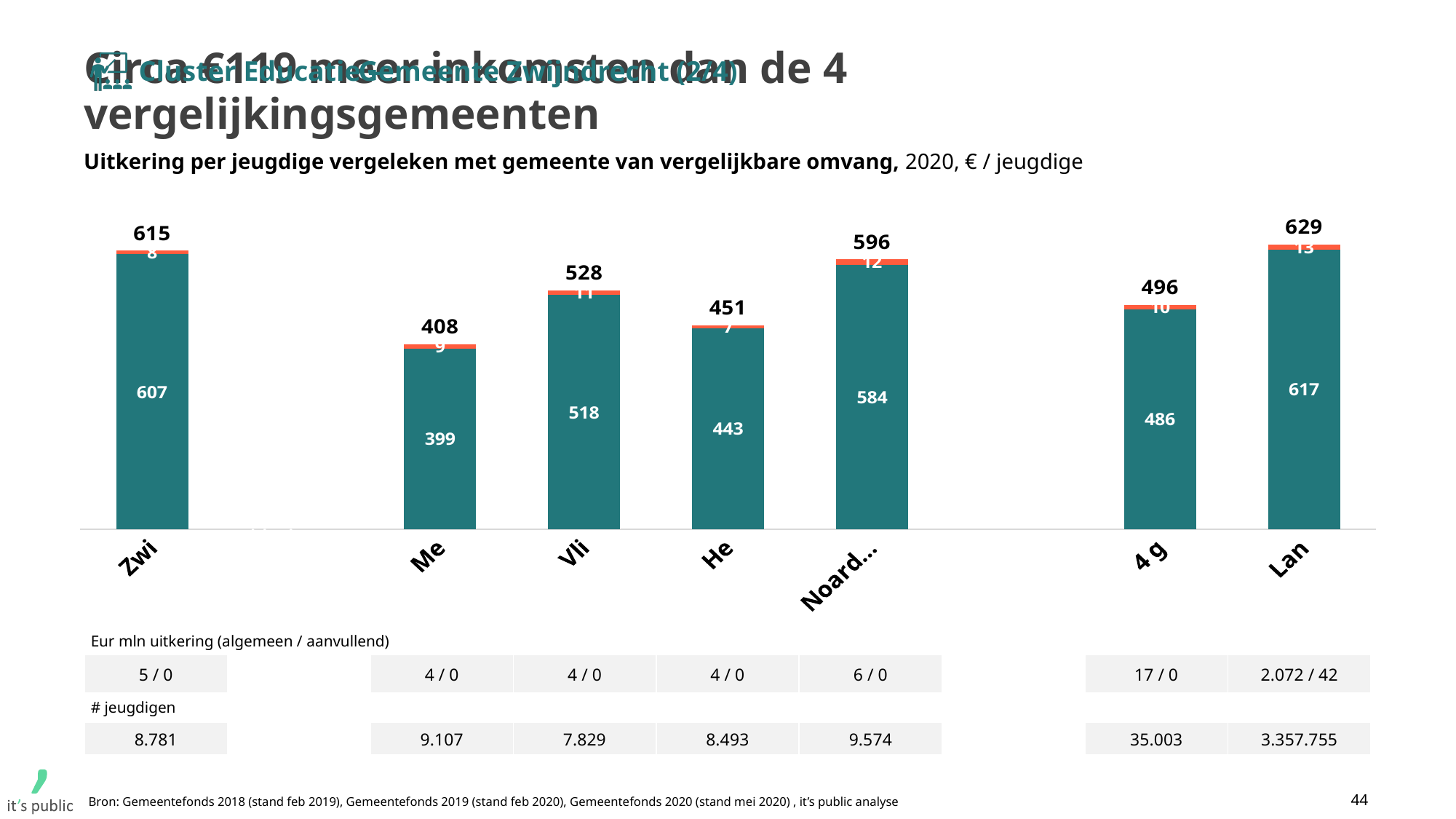
In what unit are the chart values expressed, according to the subtitle? € / jeugdige What is the total value shown above the bar for Noard...? 596 What is the difference between the total for Zwi and the total for 4 g? 119 What is the value of the large lower segment of the bar for Lan? 617 Which category has the lowest total value? Me What is the difference between the total for Lan and the total for Zwi? 14 What kind of chart is shown on the slide? Stacked bar chart How many bars are shown in the chart? 7 What is the value of the large lower segment of the bar for Me? 399 Which category has the highest total value? Lan Which has a larger total, Vli or He? Vli What is the total value shown above the bar for Zwi? 615